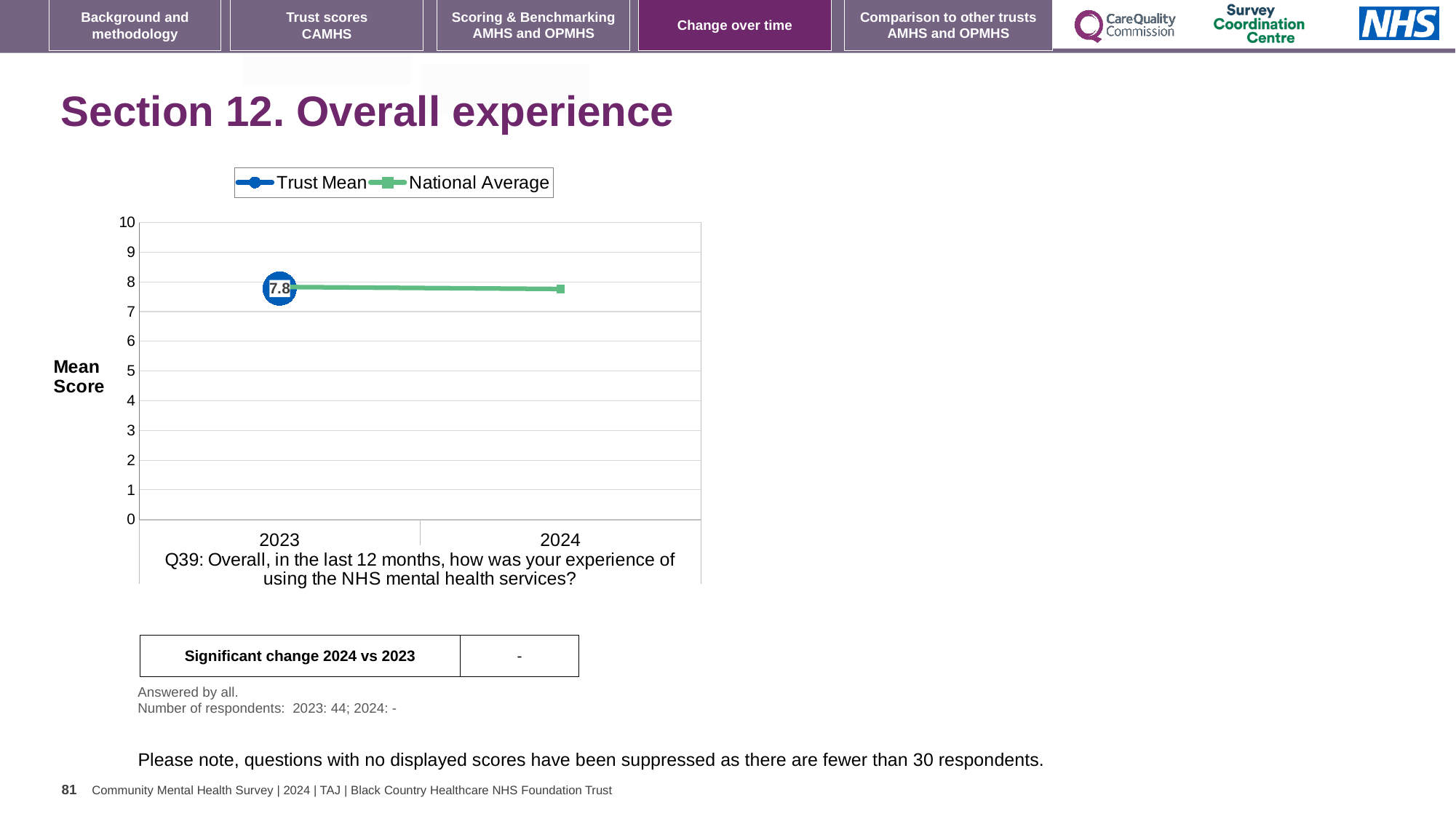
Is the National Average value for 2024 greater or less than 5? greater What is the Trust Mean value for 2023? 7.8 What is the label on the y axis of the chart? Mean Score Which series is shown in blue in the legend? Trust Mean Is the Trust Mean value for 2023 greater or less than 7? greater Is the National Average value for 2023 greater or less than 9? less How many series does the legend list? 2 What kind of chart is shown on the slide? line chart How many years are shown on the x axis? 2 What is the highest value shown on the y axis? 10